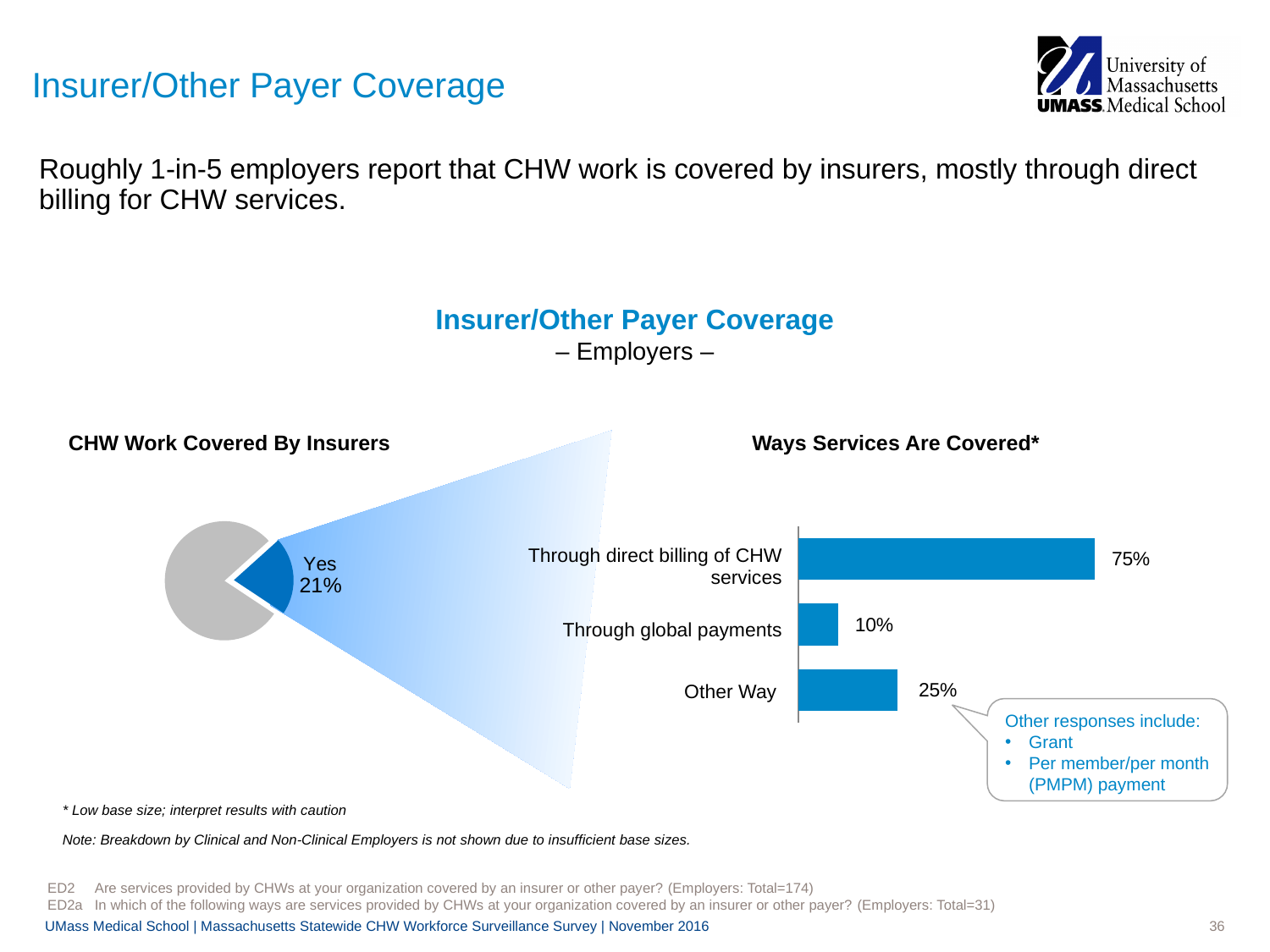
In the 'Ways Services Are Covered*' chart, what is the value for 'Other Way'? 25% In the 'Ways Services Are Covered*' chart, which category has the lowest value? Through global payments In the 'CHW Work Covered By Insurers' chart, what share of employers answered Yes? 21% In the 'Ways Services Are Covered*' chart, what is the difference between 'Through direct billing of CHW services' and 'Other Way'? 50% In the 'Ways Services Are Covered*' chart, what is the value for 'Through direct billing of CHW services'? 75% In the 'Ways Services Are Covered*' chart, which is larger: 'Other Way' or 'Through global payments'? Other Way In the 'Ways Services Are Covered*' chart, which category has the highest value? Through direct billing of CHW services In the 'Ways Services Are Covered*' chart, what is the value for 'Through global payments'? 10% What kind of chart is 'Ways Services Are Covered*'? bar chart What is the title of the bar chart on the right side of the slide? Ways Services Are Covered* How many categories are shown in the 'Ways Services Are Covered*' chart? 3 What kind of chart is 'CHW Work Covered By Insurers'? pie chart